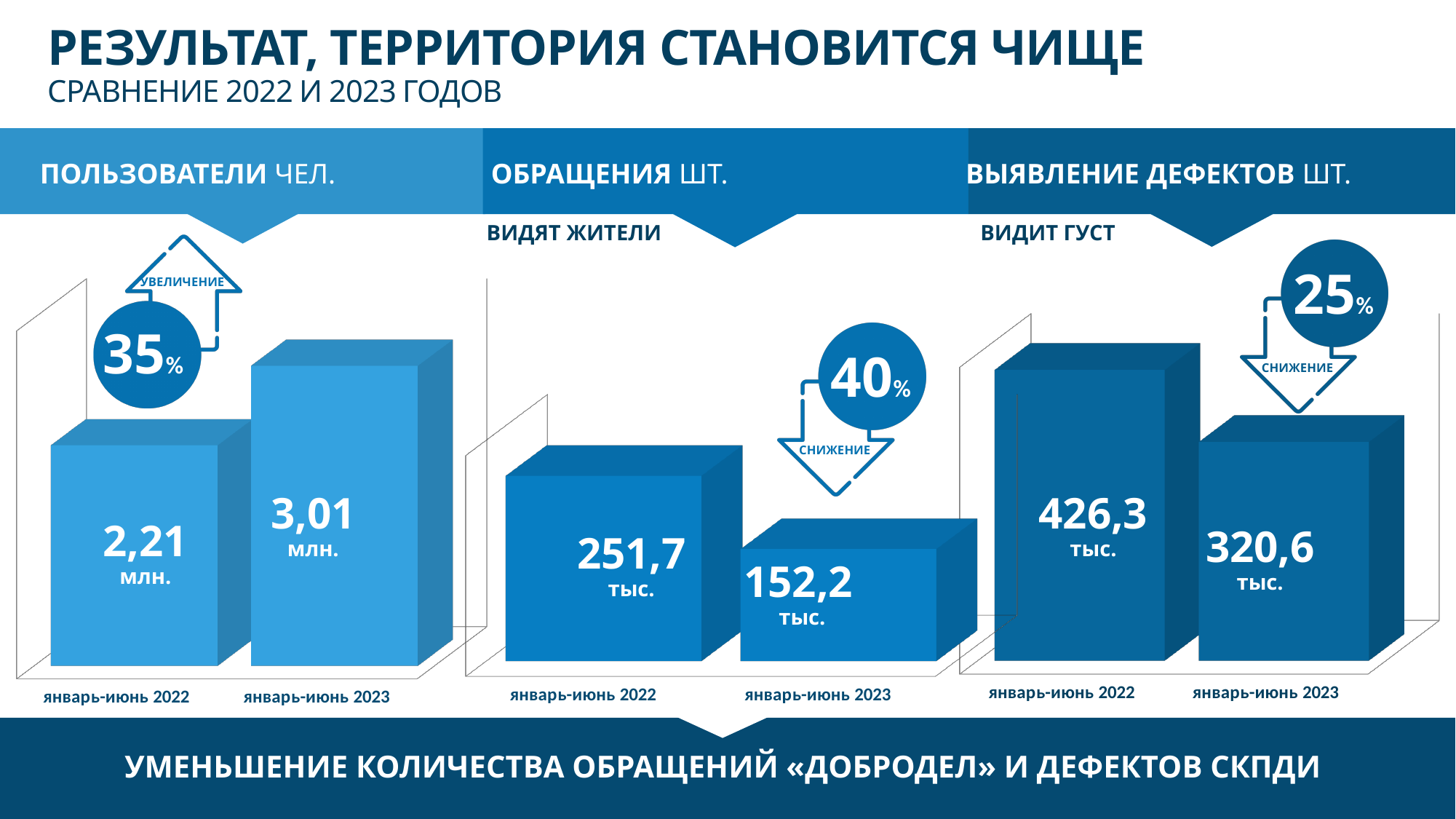
In the "ПОЛЬЗОВАТЕЛИ ЧЕЛ." chart, what is the value for январь-июнь 2023? 3,01 млн. In the "ВЫЯВЛЕНИЕ ДЕФЕКТОВ ШТ." chart, what is the difference between январь-июнь 2022 and январь-июнь 2023? 105,7 тыс. In the "ОБРАЩЕНИЯ ШТ." chart, what is the value for январь-июнь 2022? 251,7 тыс. In the "ОБРАЩЕНИЯ ШТ." chart, do the values rise or fall from январь-июнь 2022 to январь-июнь 2023? fall What percentage change is shown for the "ОБРАЩЕНИЯ ШТ." chart? 40% снижение In the "ВЫЯВЛЕНИЕ ДЕФЕКТОВ ШТ." chart, what is the value for январь-июнь 2022? 426,3 тыс. In the "ПОЛЬЗОВАТЕЛИ ЧЕЛ." chart, what is the value for январь-июнь 2022? 2,21 млн. In the "ОБРАЩЕНИЯ ШТ." chart, which period has the lower value? январь-июнь 2023 In the "ВЫЯВЛЕНИЕ ДЕФЕКТОВ ШТ." chart, what is the value for январь-июнь 2023? 320,6 тыс. In the "ПОЛЬЗОВАТЕЛИ ЧЕЛ." chart, which period has the higher value? январь-июнь 2023 In the "ОБРАЩЕНИЯ ШТ." chart, what is the value for январь-июнь 2023? 152,2 тыс. What kind of chart is used in the "ВЫЯВЛЕНИЕ ДЕФЕКТОВ ШТ." section? bar chart